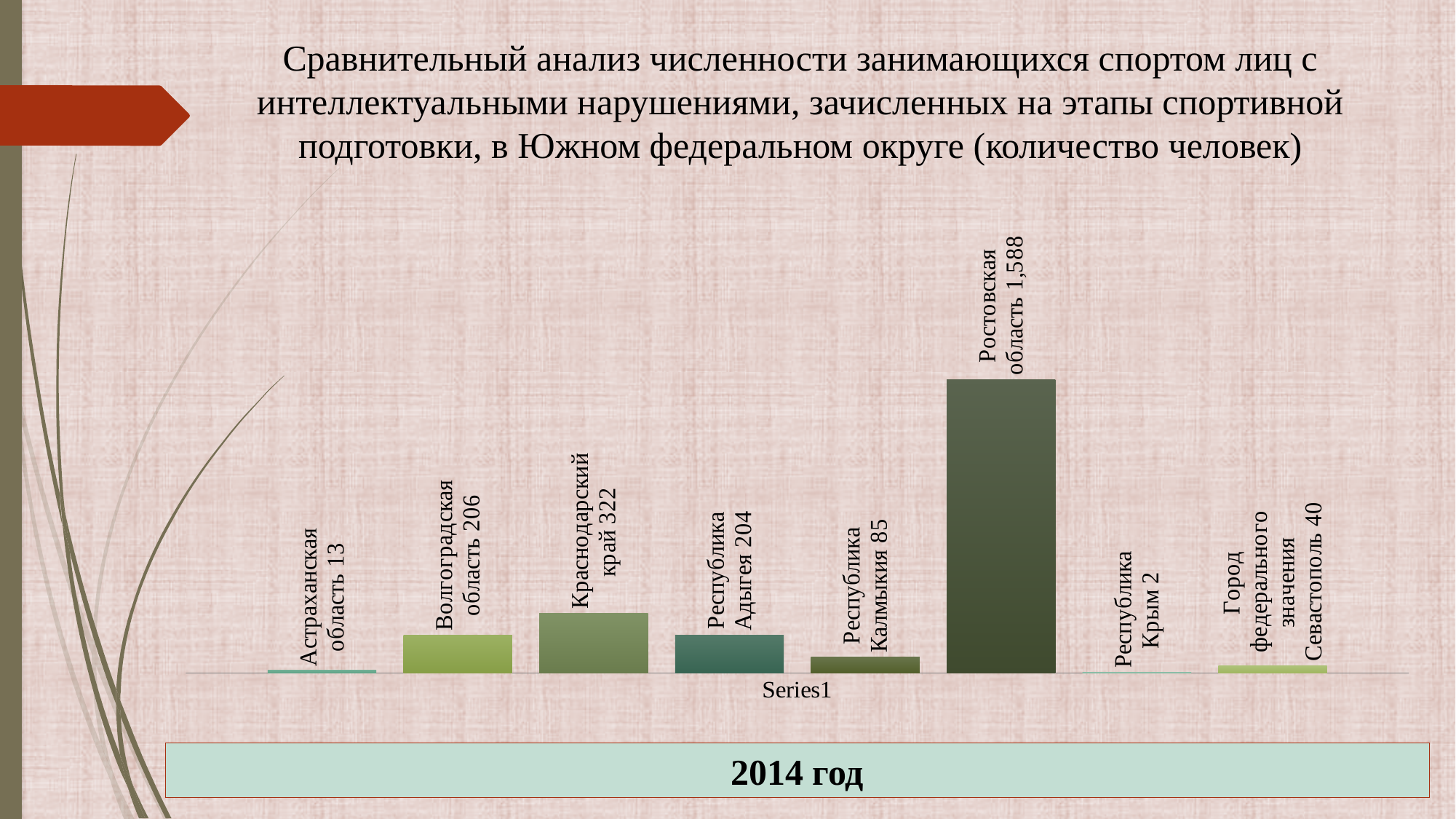
Which region has the highest value? Ростовская область Which region has the lowest value? Республика Крым What year is shown in the box below the chart? 2014 год Which is larger, the value for Волгоградская область or the value for Республика Адыгея? Волгоградская область What is the value for Республика Калмыкия? 85 What kind of chart is shown on the slide? bar chart What is the difference between the values for Краснодарский край and Волгоградская область? 116 What is the value for Краснодарский край? 322 How many regions are shown in the chart? 8 What is the value for Город федерального значения Севастополь? 40 What is the value for Ростовская область? 1,588 What is the difference between the values for Астраханская область and Республика Крым? 11